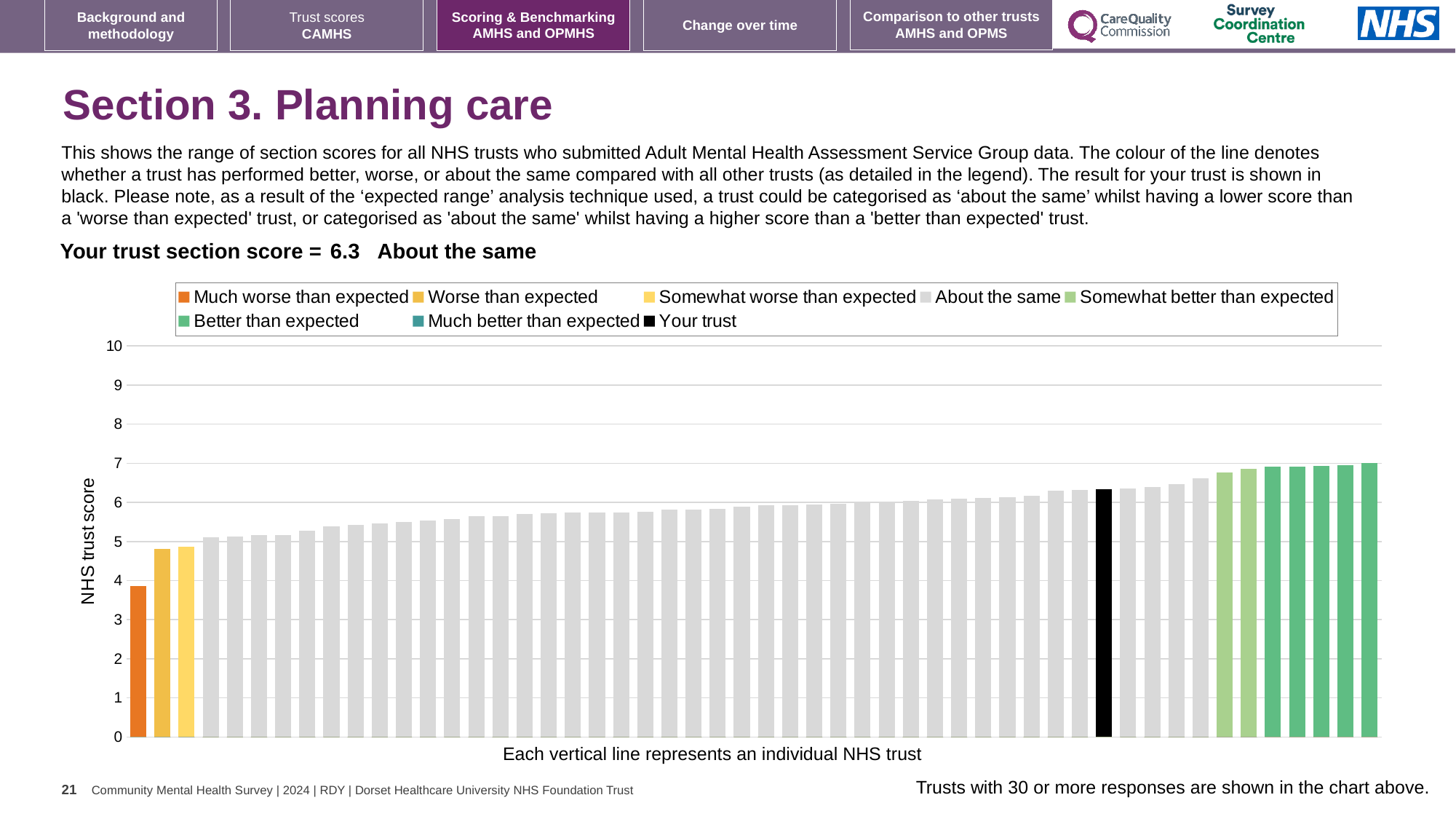
Which performance category is your trust placed in for this section? About the same Is the value of the lowest bar (the orange bar) greater or less than 5? less Do the bar values rise or fall moving from left to right along the x axis? rise What is the label on the vertical axis of the chart? NHS trust score How many bars are coloured orange (Much worse than expected)? 1 What kind of chart is shown on the slide? bar chart Is the value of the highest bar in the chart greater or less than 8? less How many bars are coloured dark green (Better than expected)? 5 How many entries does the chart legend list? 8 Is the value for your trust (the black bar) greater or less than 6? greater What colour is the bar representing your trust? black What is the section score for your trust shown on the slide? 6.3